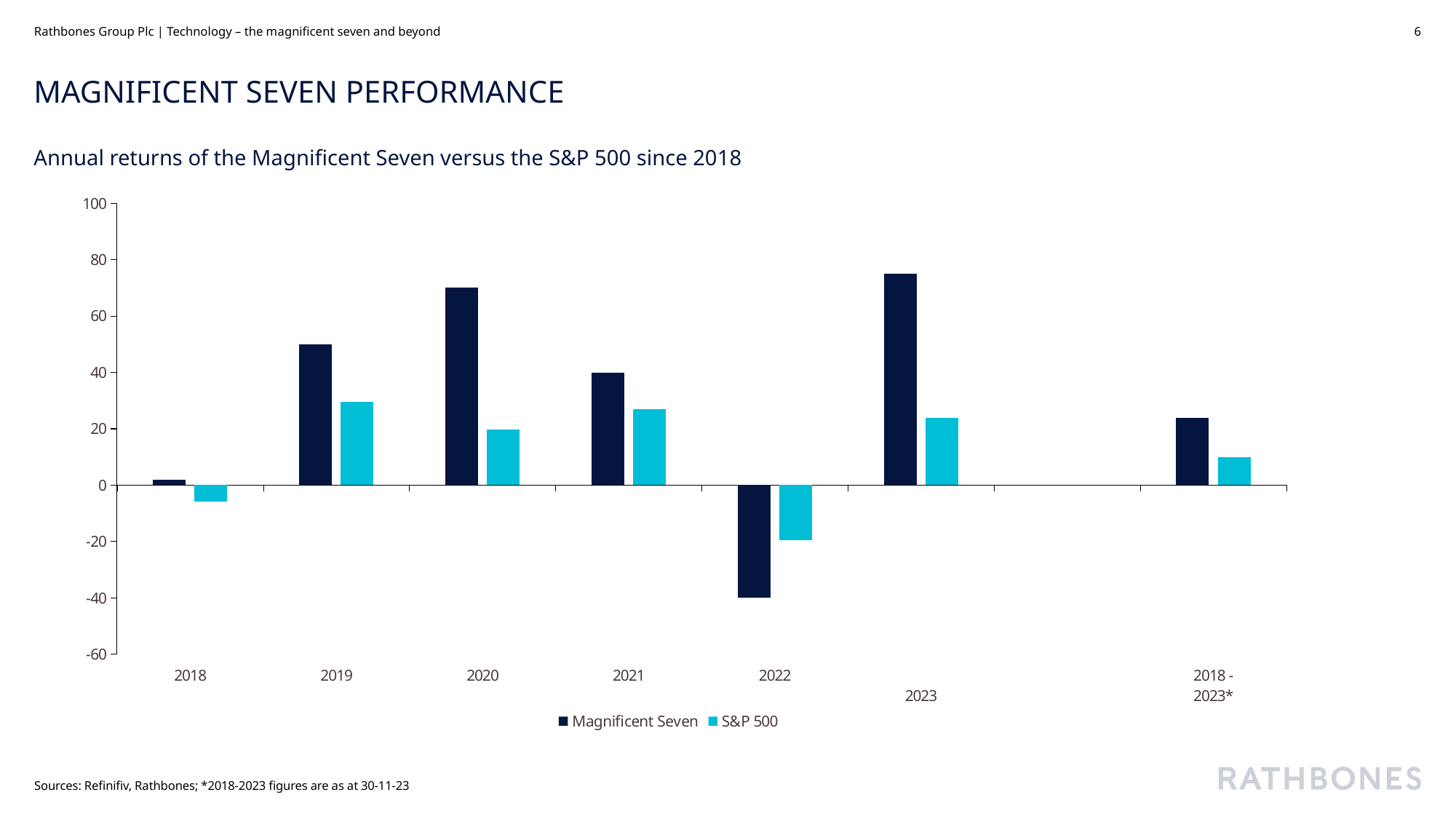
What is the subtitle describing the chart? Annual returns of the Magnificent Seven versus the S&P 500 since 2018 Which is larger in 2021, the Magnificent Seven return or the S&P 500 return? Magnificent Seven Is the Magnificent Seven value for 2020 greater or less than 60? greater In which year is the S&P 500 return the lowest? 2022 Is the Magnificent Seven value for 2022 greater or less than -20? less How many categories are shown along the x axis? 7 How many series does the legend list? 2 Is the S&P 500 value for 2019 greater or less than 20? greater In which year is the Magnificent Seven return the highest? 2023 In which year is the Magnificent Seven return the lowest? 2022 Which series is shown in dark navy bars? Magnificent Seven What kind of chart is shown on the slide? bar chart